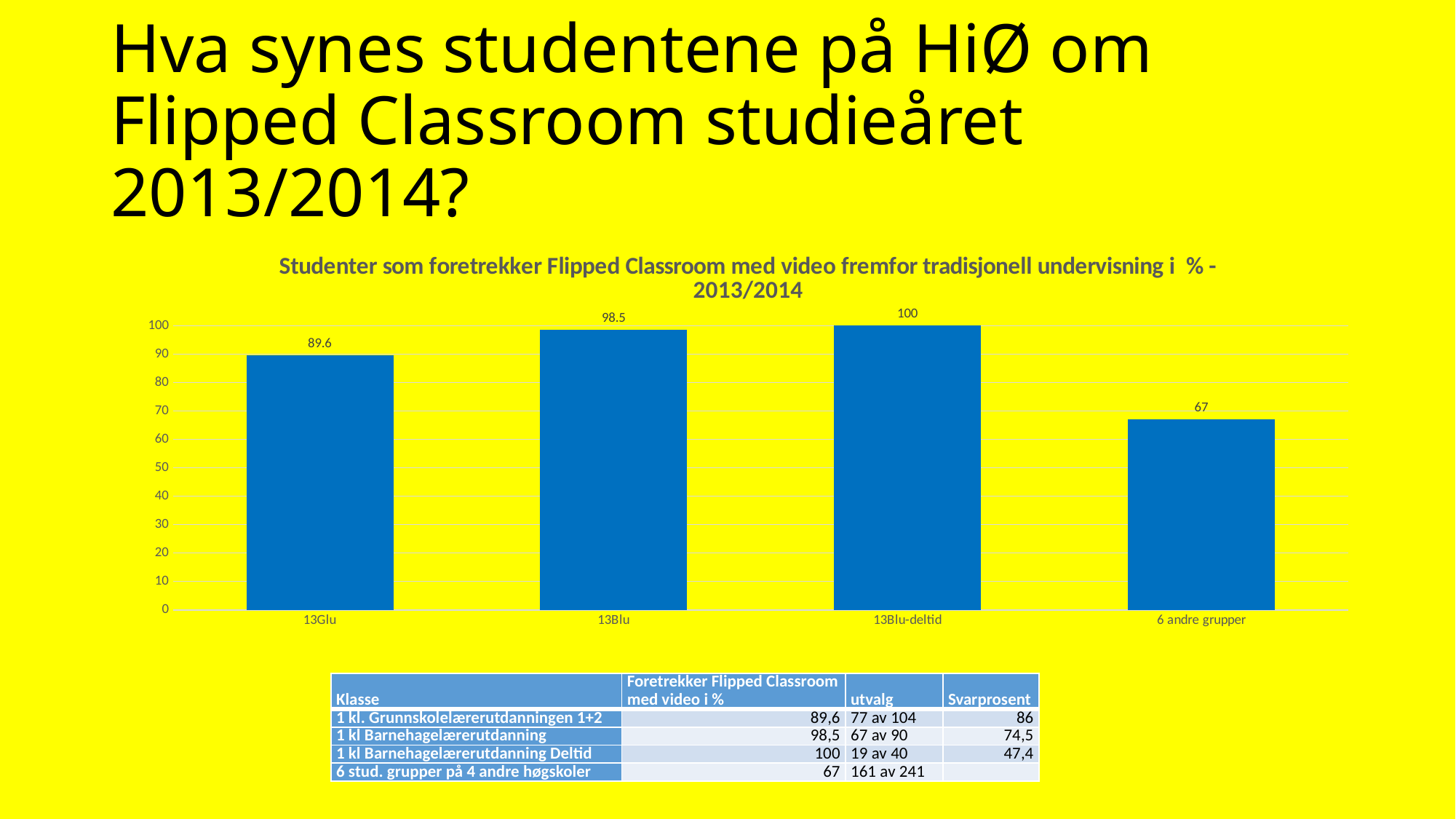
How many categories are shown on the x axis? 4 What is the value for 13Glu? 89.6 What is the value for 6 andre grupper? 67 What is the difference between the values for 13Blu-deltid and 6 andre grupper? 33 Which category has the highest value? 13Blu-deltid Is the value for 13Glu greater or less than 80? greater What is the difference between the values for 13Blu and 13Glu? 8.9 What is the value for 13Blu-deltid? 100 Which is larger, the value for 13Glu or the value for 6 andre grupper? 13Glu What kind of chart is shown on the slide? bar chart What is the value for 13Blu? 98.5 Which category has the lowest value? 6 andre grupper